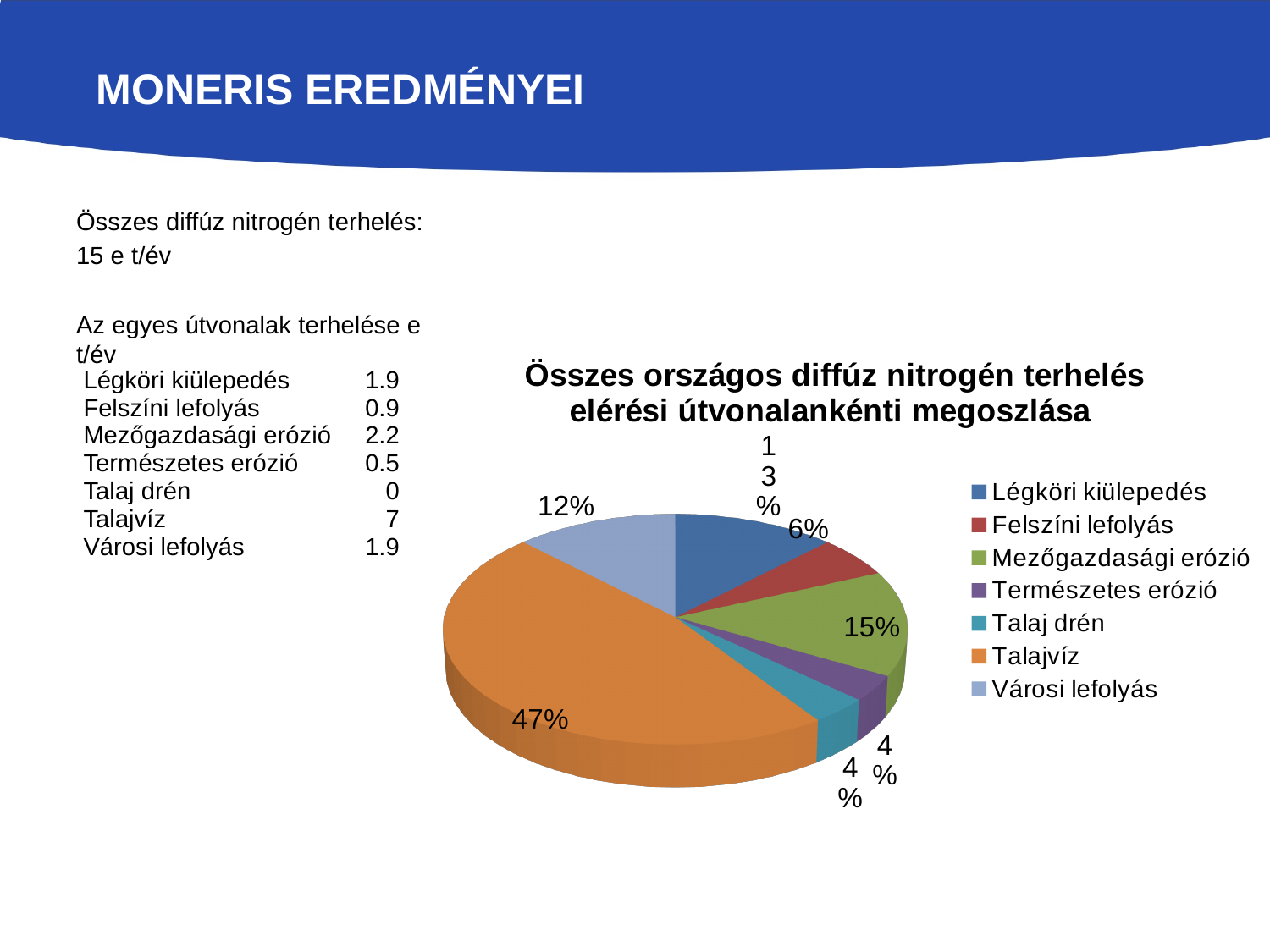
What share of the pie does Talajvíz represent? 47% What is the percentage shown for Mezőgazdasági erózió? 15% What is the percentage shown for Városi lefolyás? 12% What type of chart is shown on the slide? pie chart What is the title of the chart? Összes országos diffúz nitrogén terhelés elérési útvonalankénti megoszlása What is the difference in percentage points between the Talajvíz slice and the Mezőgazdasági erózió slice? 32 percentage points Which category has the largest slice of the pie? Talajvíz How many slices does the pie chart have? 7 Which is larger, the share for Felszíni lefolyás or the share for Városi lefolyás? Városi lefolyás What is the percentage shown for Légköri kiülepedés? 13% How many entries does the chart legend list? 7 What is the percentage shown for Felszíni lefolyás? 6%